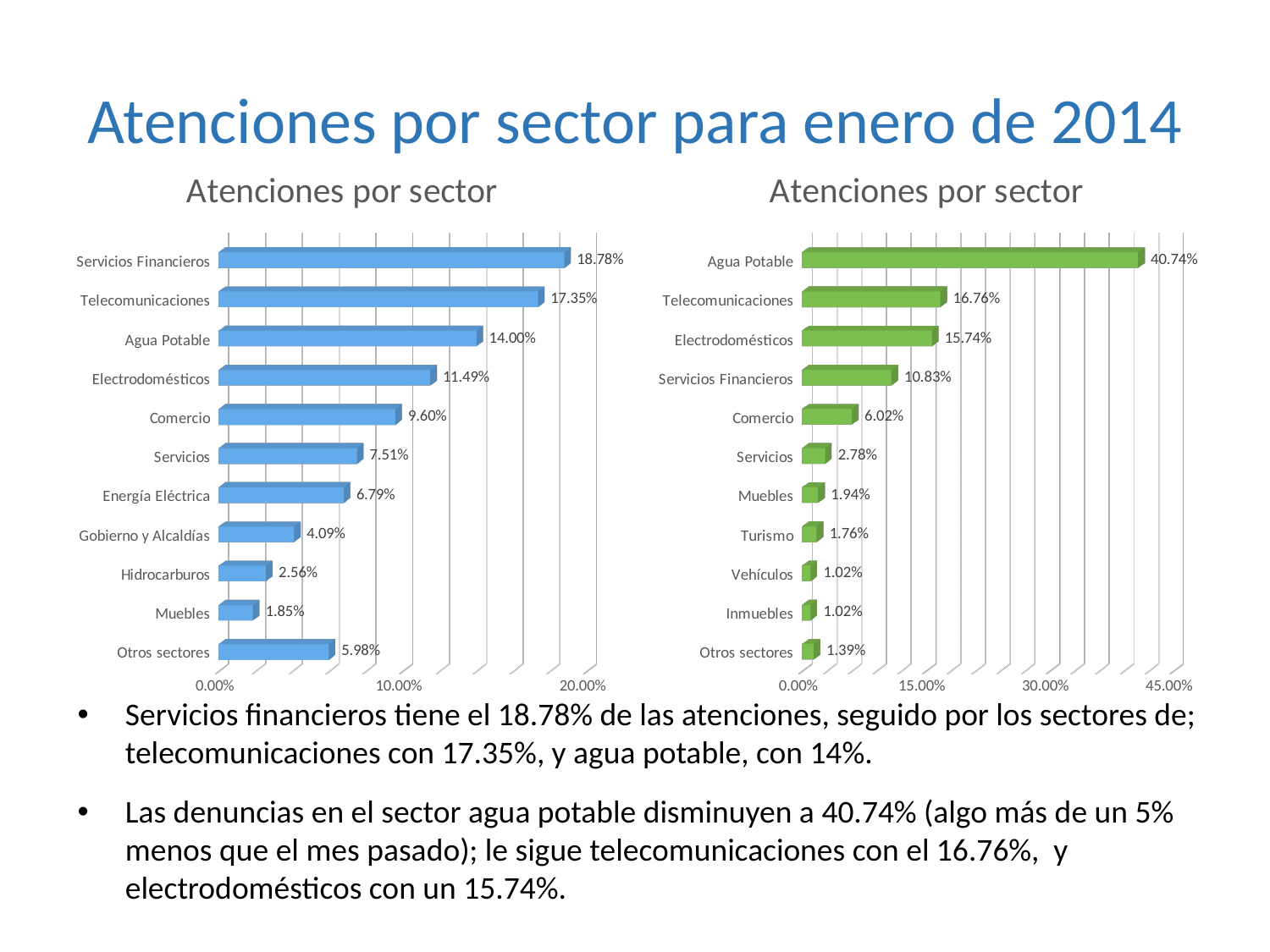
How many sectors are shown in the right (green) chart? 11 In the left (blue) chart, what is the difference between Servicios Financieros and Telecomunicaciones? 1.43% In the left (blue) chart, what is the value for Gobierno y Alcaldías? 4.09% In the right (green) chart, what is the value for Electrodomésticos? 15.74% In the left (blue) chart, which sector has the lowest value? Muebles In the right (green) chart, which is larger: Comercio or Servicios? Comercio In the left (blue) chart, what is the value for Agua Potable? 14.00% In the right (green) chart, which sector has the highest value? Agua Potable In the left (blue) chart, is the value for Electrodomésticos greater or less than 10.00%? greater In the right (green) chart, what is the difference between Agua Potable and Telecomunicaciones? 23.98% What kind of chart is the left chart on the slide? Bar chart What is the title of the right (green) chart? Atenciones por sector